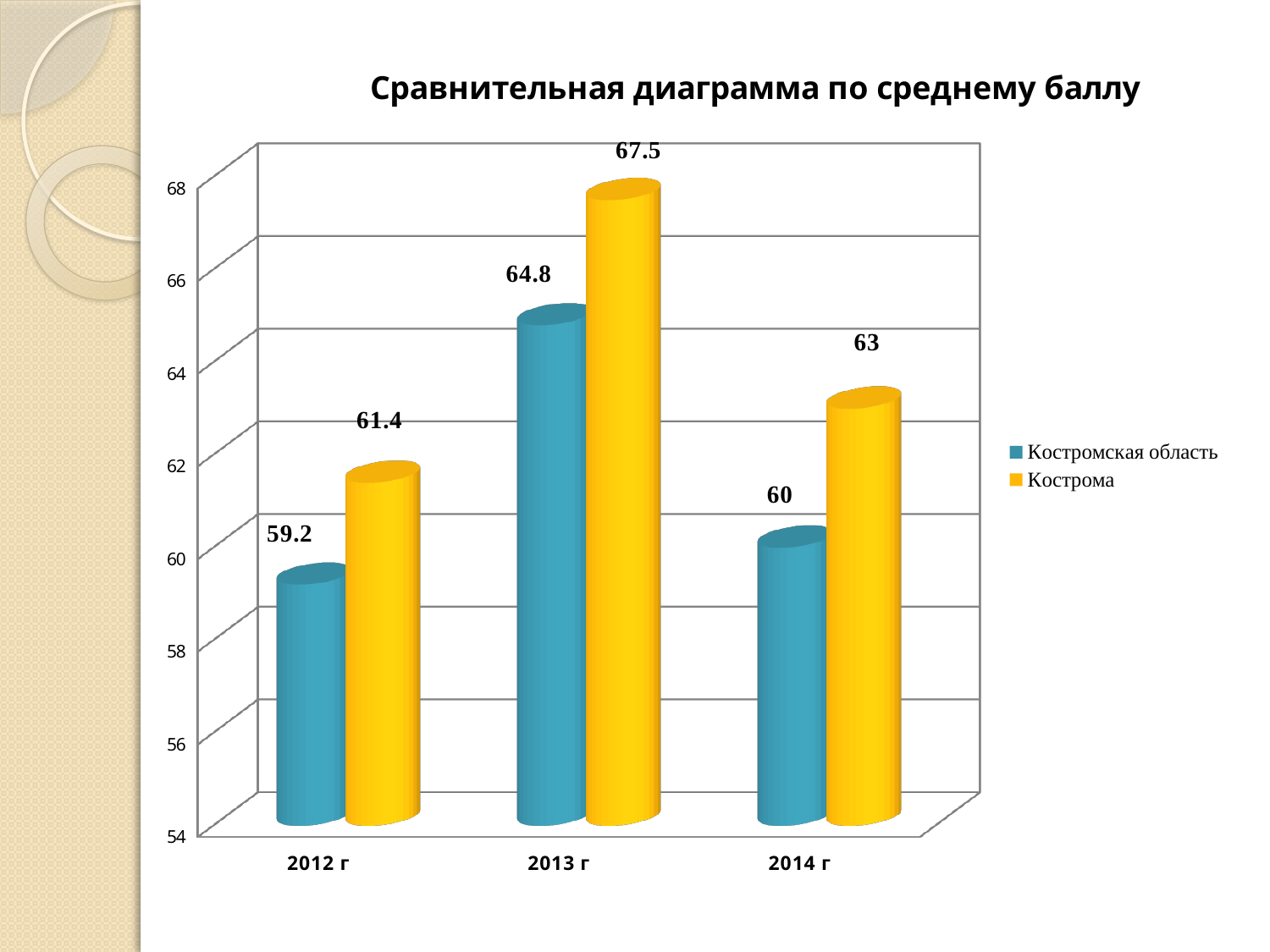
What is the difference between Кострома and Костромская область in 2013 г? 2.7 How many series does the legend list? 2 In which year is the value for Кострома highest? 2013 г What is the value for Костромская область in 2013 г? 64.8 Is the value for Костромская область in 2012 г greater or less than 60? less Which is larger in 2014 г: Костромская область or Кострома? Кострома What kind of chart is shown on the slide? bar chart In which year is the value for Костромская область lowest? 2012 г What is the value for Кострома in 2014 г? 63 What is the value for Кострома in 2012 г? 61.4 How many years are shown on the x axis? 3 What is the title of the chart? Сравнительная диаграмма по среднему баллу